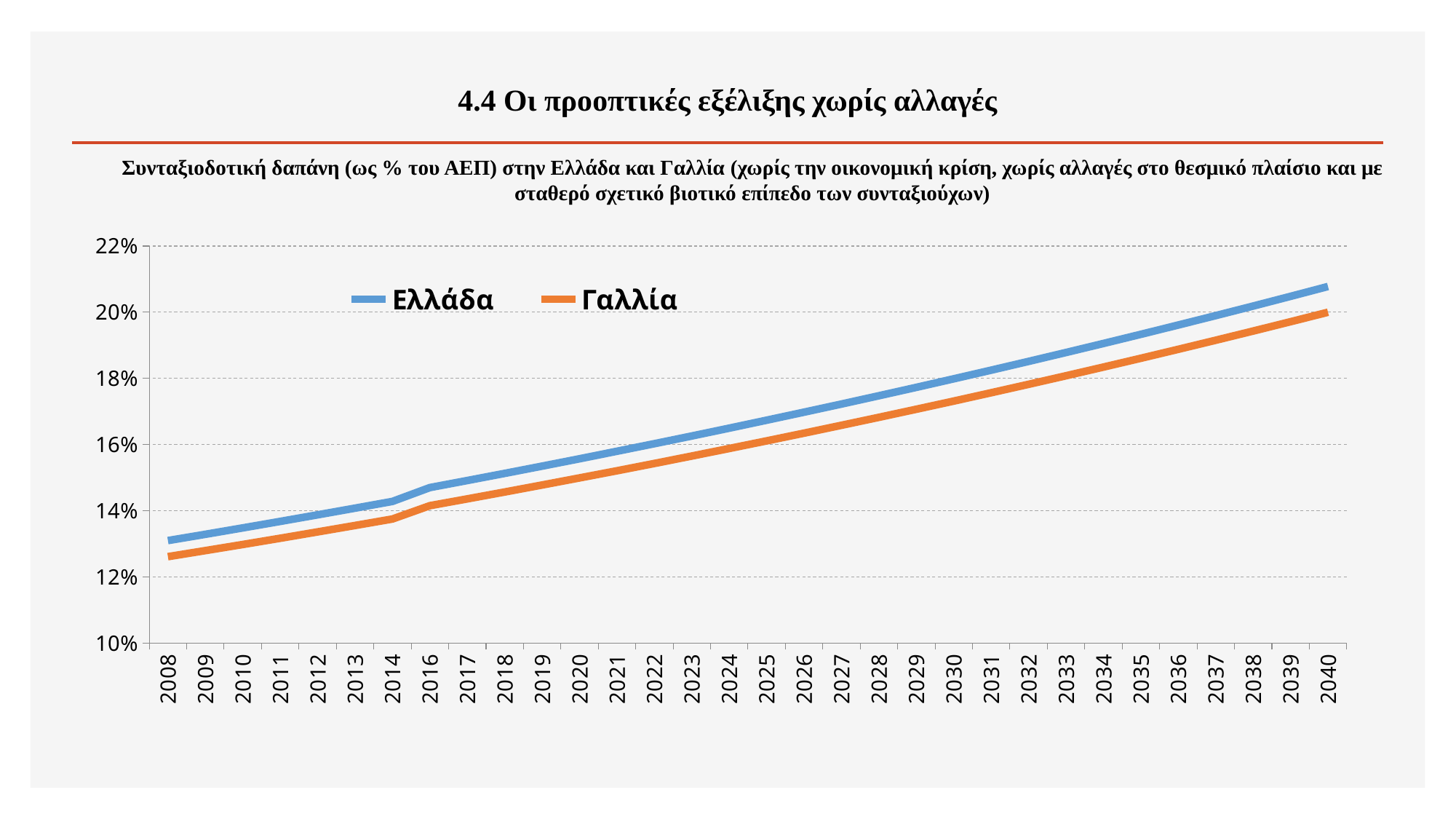
In which year is the value for Ελλάδα highest? 2040 In which year is the value for Γαλλία lowest? 2008 How many series does the legend list? 2 What colour is the line for Ελλάδα? blue Is the value for Γαλλία in 2008 greater or less than 14%? less Which series has the larger value in 2040, Ελλάδα or Γαλλία? Ελλάδα Do the values for Ελλάδα rise or fall from 2008 to 2040? rise How many years are shown on the x axis? 32 Which two series are shown in the legend? Ελλάδα and Γαλλία What kind of chart is shown on the slide? line chart Is the value for Ελλάδα in 2040 greater or less than 20%? greater Do the values for Γαλλία rise or fall from 2008 to 2040? rise